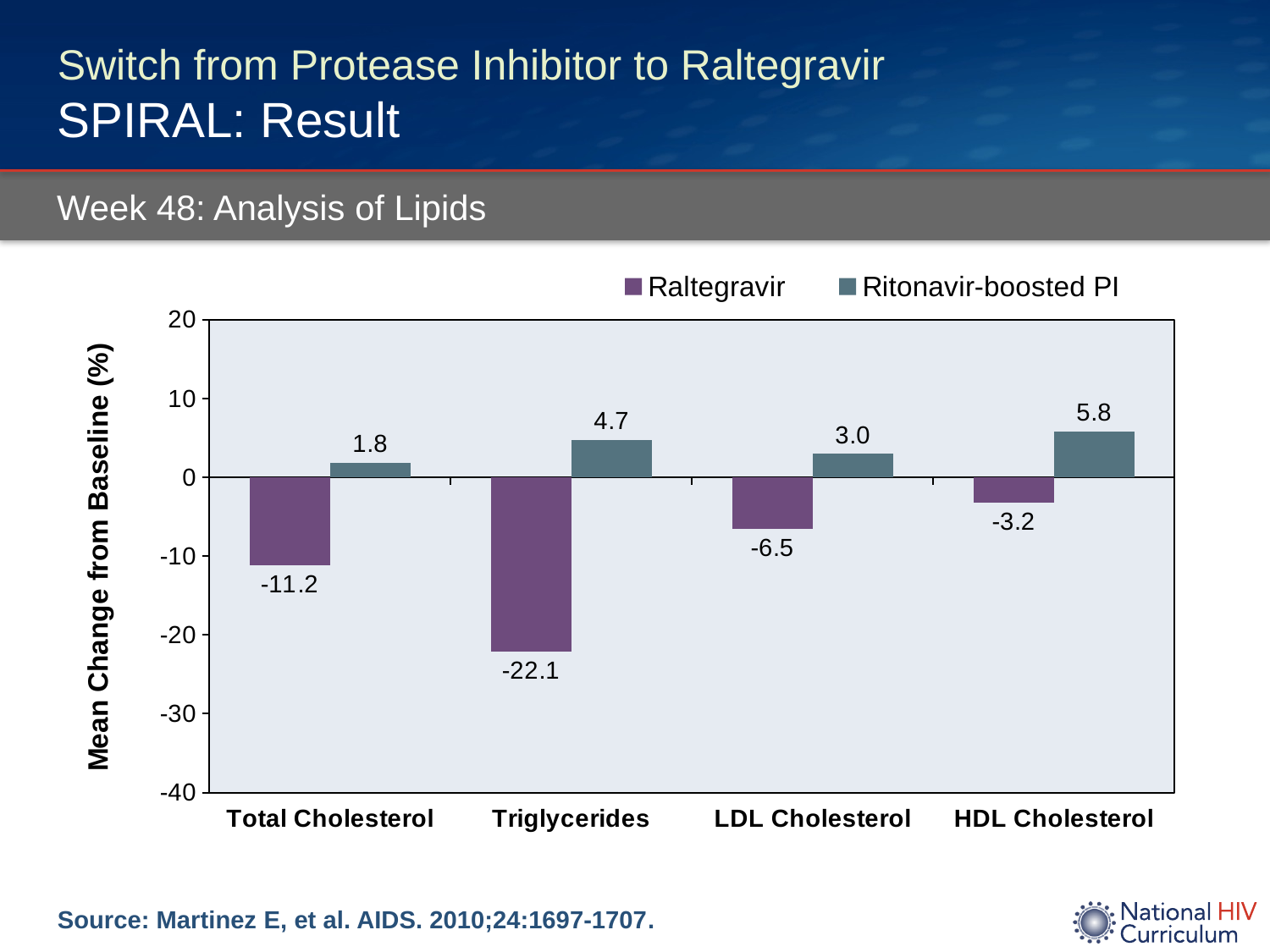
What is the mean change from baseline for Raltegravir in Total Cholesterol? -11.2 How many series does the legend list? 2 Which lipid category has the highest value for Ritonavir-boosted PI? HDL Cholesterol Which lipid category has the lowest value for Raltegravir? Triglycerides What is the mean change from baseline for Ritonavir-boosted PI in LDL Cholesterol? 3.0 What is the mean change from baseline for Ritonavir-boosted PI in Triglycerides? 4.7 What kind of chart is shown on the slide? Bar chart What is the difference between the Ritonavir-boosted PI and Raltegravir values for Triglycerides? 26.8 Which is larger for LDL Cholesterol: the Raltegravir value or the Ritonavir-boosted PI value? Ritonavir-boosted PI What is the label of the y axis? Mean Change from Baseline (%) What is the mean change from baseline for Raltegravir in HDL Cholesterol? -3.2 How many lipid categories are shown on the x axis? 4